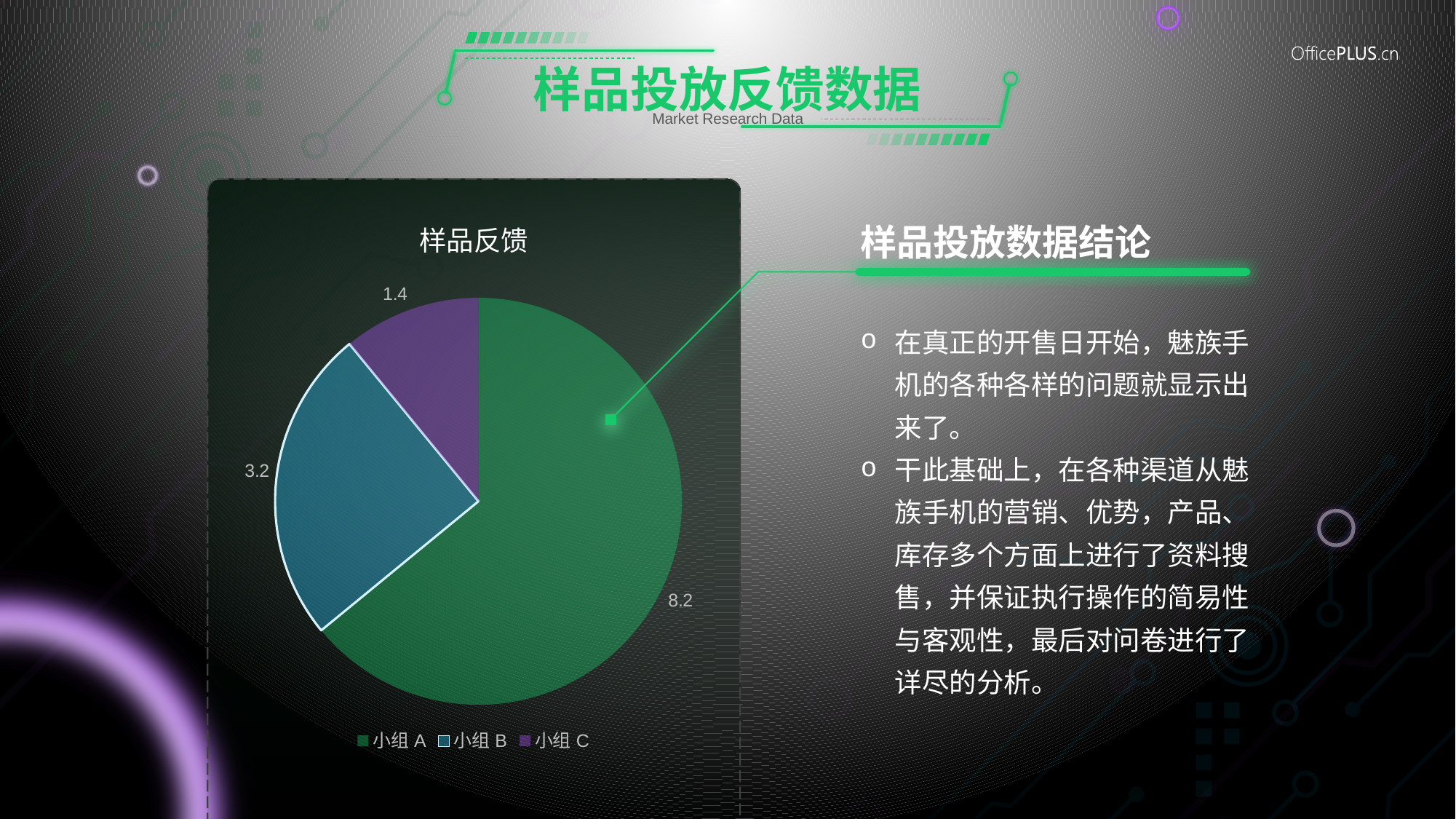
What is the value for 小组 A? 8.2 What share of the pie does 小组 B represent? 25% What is the title of the chart? 样品反馈 Which is larger, the value for 小组 B or the value for 小组 C? 小组 B Which group has the smallest slice of the pie? 小组 C Which group has the largest slice of the pie? 小组 A How many slices does the pie chart have? 3 What kind of chart is shown on the slide? pie chart What is the difference between the values for 小组 B and 小组 C? 1.8 What is the value for 小组 B? 3.2 What is the difference between the values for 小组 A and 小组 B? 5.0 What is the value for 小组 C? 1.4